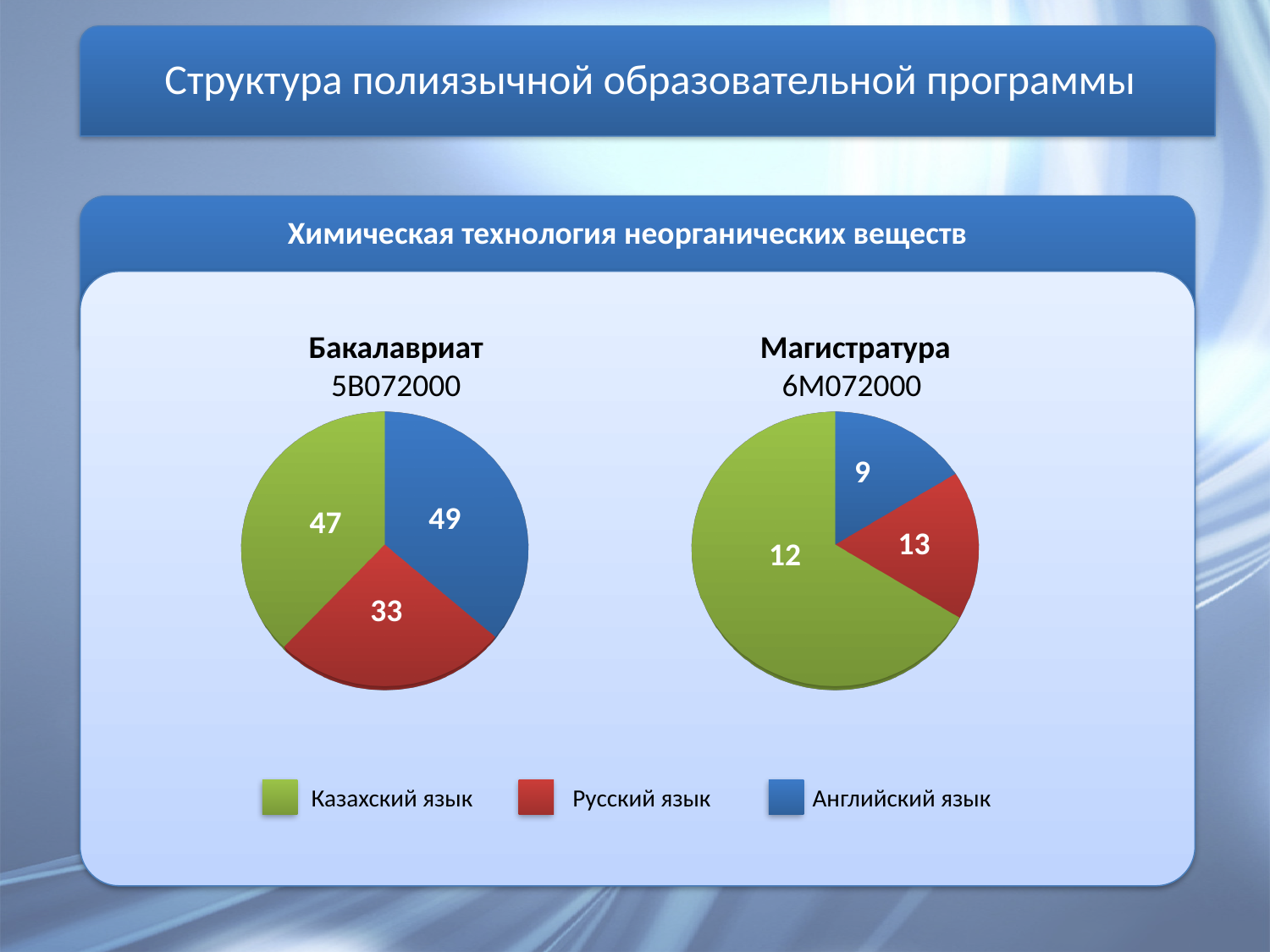
In the Магистратура 6M072000 pie chart, what is the value for Казахский язык? 12 How many entries does the shared legend below the pie charts list? 3 In the Магистратура 6M072000 pie chart, what is the value for Русский язык? 13 In the Магистратура 6M072000 pie chart, what is the difference between the values for Русский язык and Английский язык? 4 In the Бакалавриат 5B072000 pie chart, what is the difference between the values for Английский язык and Русский язык? 16 In the Бакалавриат 5B072000 pie chart, what is the value for Русский язык? 33 How many slices does the Магистратура 6M072000 pie chart have? 3 In the Бакалавриат 5B072000 pie chart, which language has the lowest value? Русский язык In the Бакалавриат 5B072000 pie chart, what is the value for Казахский язык? 47 In the Магистратура 6M072000 pie chart, what is the value for Английский язык? 9 What kind of chart is used for Бакалавриат 5B072000? Pie chart In the Бакалавриат 5B072000 pie chart, what is the value for Английский язык? 49